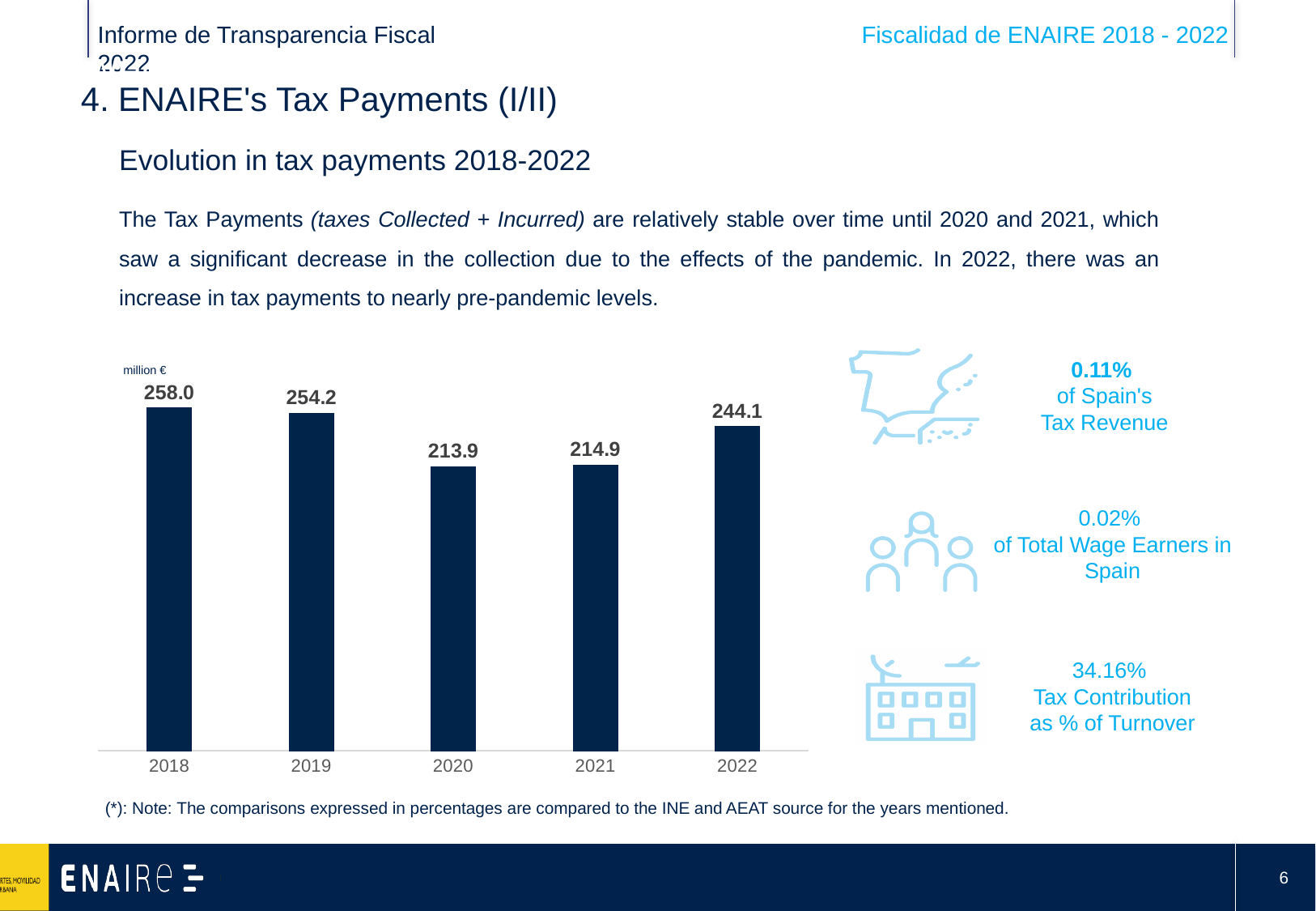
What type of chart is used to show the evolution in tax payments? Bar chart What is the tax payment value for 2020? 213.9 Which year has the lowest tax payments? 2020 Which year has higher tax payments, 2019 or 2021? 2019 How many years are shown in the bar chart? 5 What is the difference between the tax payments in 2018 and 2022? 13.9 What unit is indicated for the values in the bar chart? million € What is the tax payment value for 2018? 258.0 What is the difference between the tax payments in 2019 and 2020? 40.3 Do the tax payments rise or fall from 2018 to 2020? Fall Which year has the highest tax payments? 2018 What is the tax payment value for 2022? 244.1